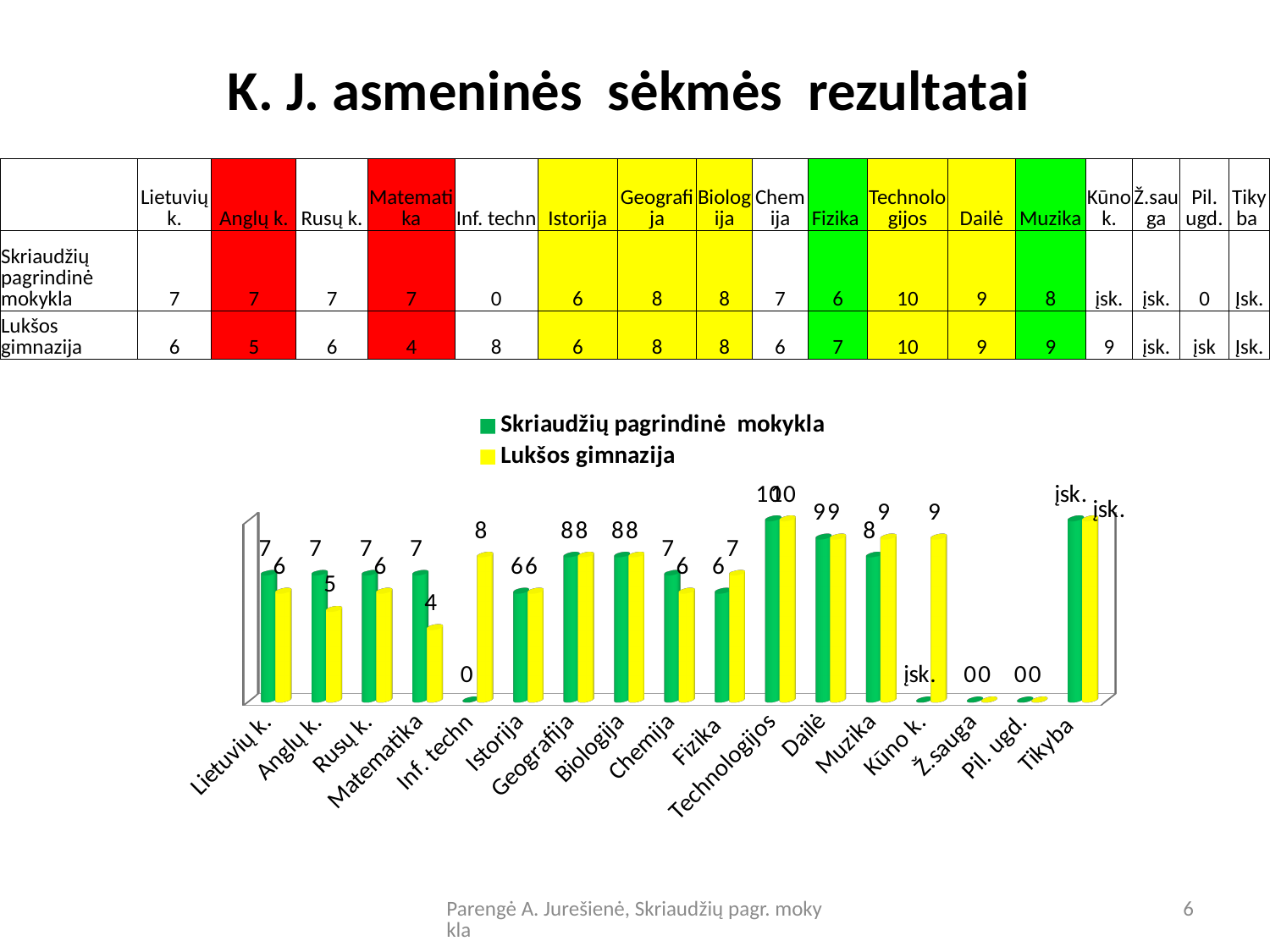
Which colour represents Lukšos gimnazija in the chart? yellow How many series does the chart legend list? 2 What is the difference between the Lukšos gimnazija and Skriaudžių pagrindinė mokykla values for Inf. techn? 8 For Fizika, which series has the larger value: Skriaudžių pagrindinė mokykla or Lukšos gimnazija? Lukšos gimnazija What is the difference between the Skriaudžių pagrindinė mokykla and Lukšos gimnazija values for Matematika? 3 For Anglų k., which series has the larger value: Skriaudžių pagrindinė mokykla or Lukšos gimnazija? Skriaudžių pagrindinė mokykla What type of chart is shown on the slide? bar chart What is the value for Matematika for Lukšos gimnazija in the chart? 4 How many subject categories are plotted along the x axis of the chart? 17 What is the value for Muzika for Lukšos gimnazija in the chart? 9 What is the value for Inf. techn for Skriaudžių pagrindinė mokykla in the chart? 0